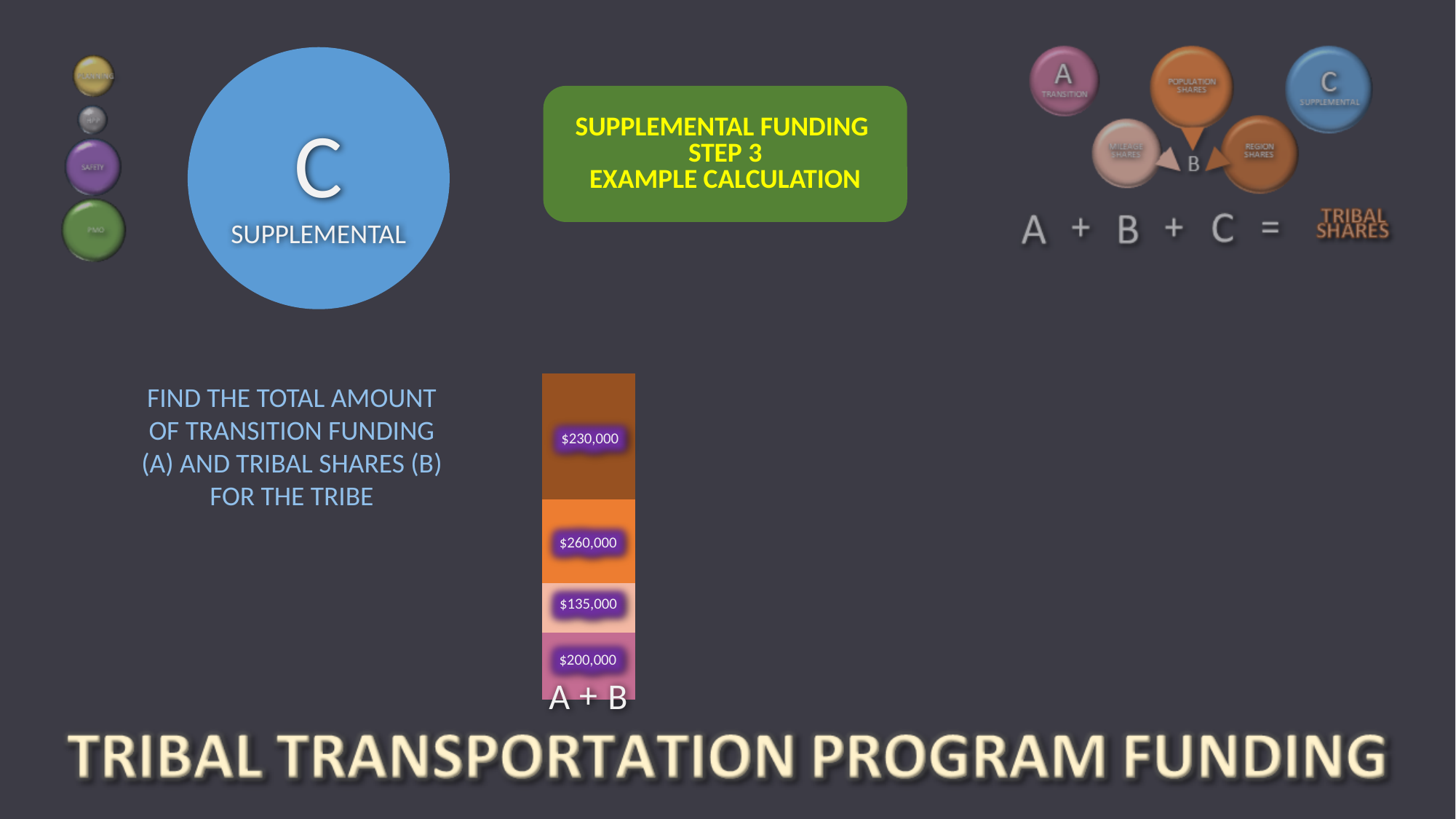
What kind of chart is shown on the slide? stacked bar chart What is the value of the light peach segment of the A + B bar? $135,000 What is the value of the bottom (pink) segment of the A + B bar? $200,000 What is the value of the orange segment of the A + B bar? $260,000 What is the total of all four segments in the A + B stacked bar? $825,000 What is the value of the topmost (brown) segment of the A + B bar? $230,000 What is the category label printed beneath the bar? A + B How many segments make up the stacked bar labeled A + B? 4 Which is larger, the brown segment or the pink segment of the A + B bar? the brown segment ($230,000) What is the difference between the largest segment ($260,000) and the smallest segment ($135,000) of the A + B bar? $125,000 Which segment of the A + B bar has the smallest value? $135,000 (light peach segment) Which segment of the A + B bar has the largest value? $260,000 (orange segment)